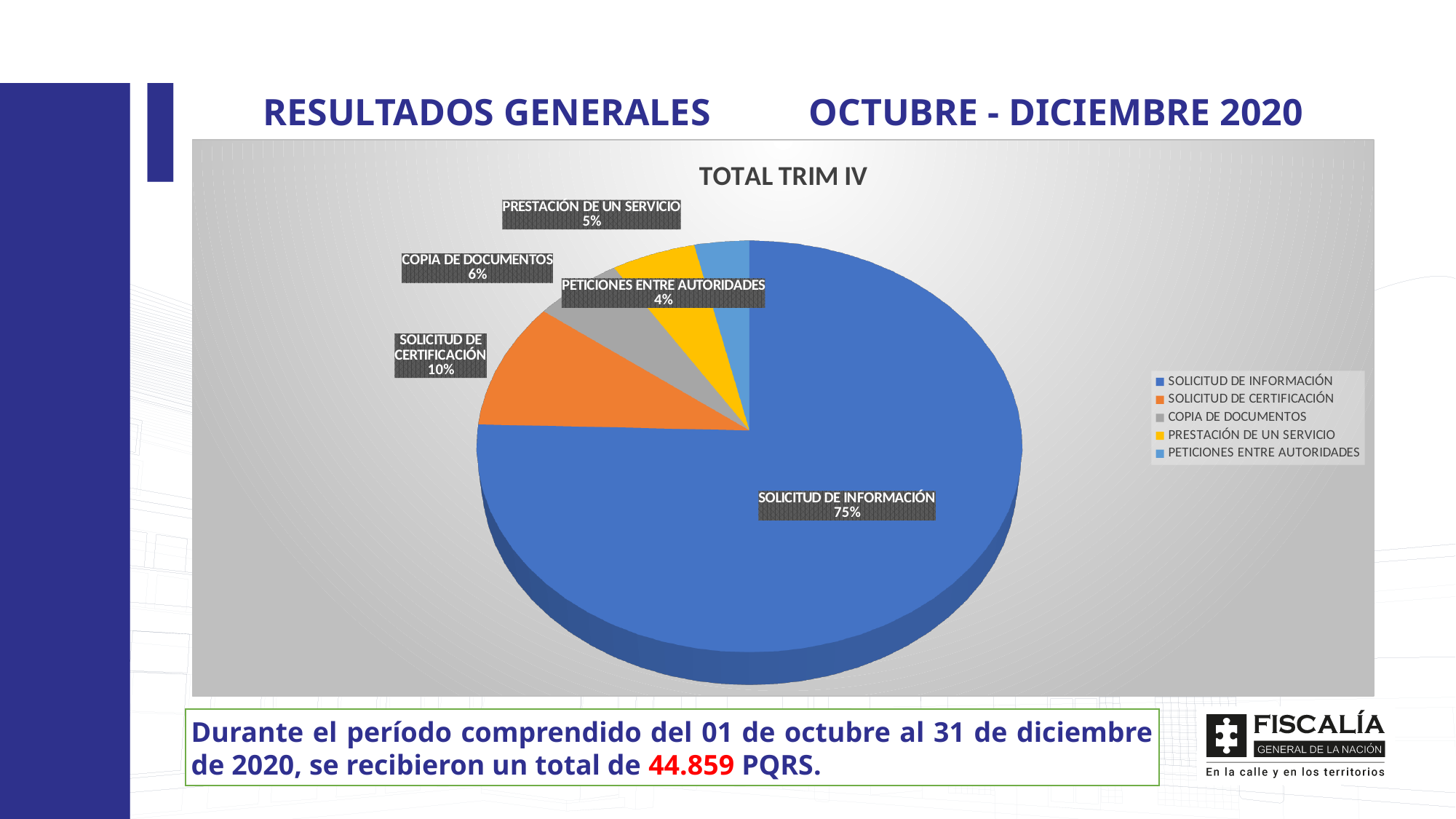
What is the title of the chart? TOTAL TRIM IV What is the value shown for COPIA DE DOCUMENTOS? 6% What is the difference in percentage points between SOLICITUD DE INFORMACIÓN and SOLICITUD DE CERTIFICACIÓN? 65 What is the value shown for PETICIONES ENTRE AUTORIDADES? 4% What kind of chart is shown on the slide? Pie chart How many categories does the pie chart show? 5 What share of the pie does SOLICITUD DE INFORMACIÓN represent? 75% What is the value shown for SOLICITUD DE CERTIFICACIÓN? 10% What is the value shown for PRESTACIÓN DE UN SERVICIO? 5% Which category has the smallest slice of the pie? PETICIONES ENTRE AUTORIDADES Which category has the largest slice of the pie? SOLICITUD DE INFORMACIÓN Which is larger, COPIA DE DOCUMENTOS or PRESTACIÓN DE UN SERVICIO? COPIA DE DOCUMENTOS